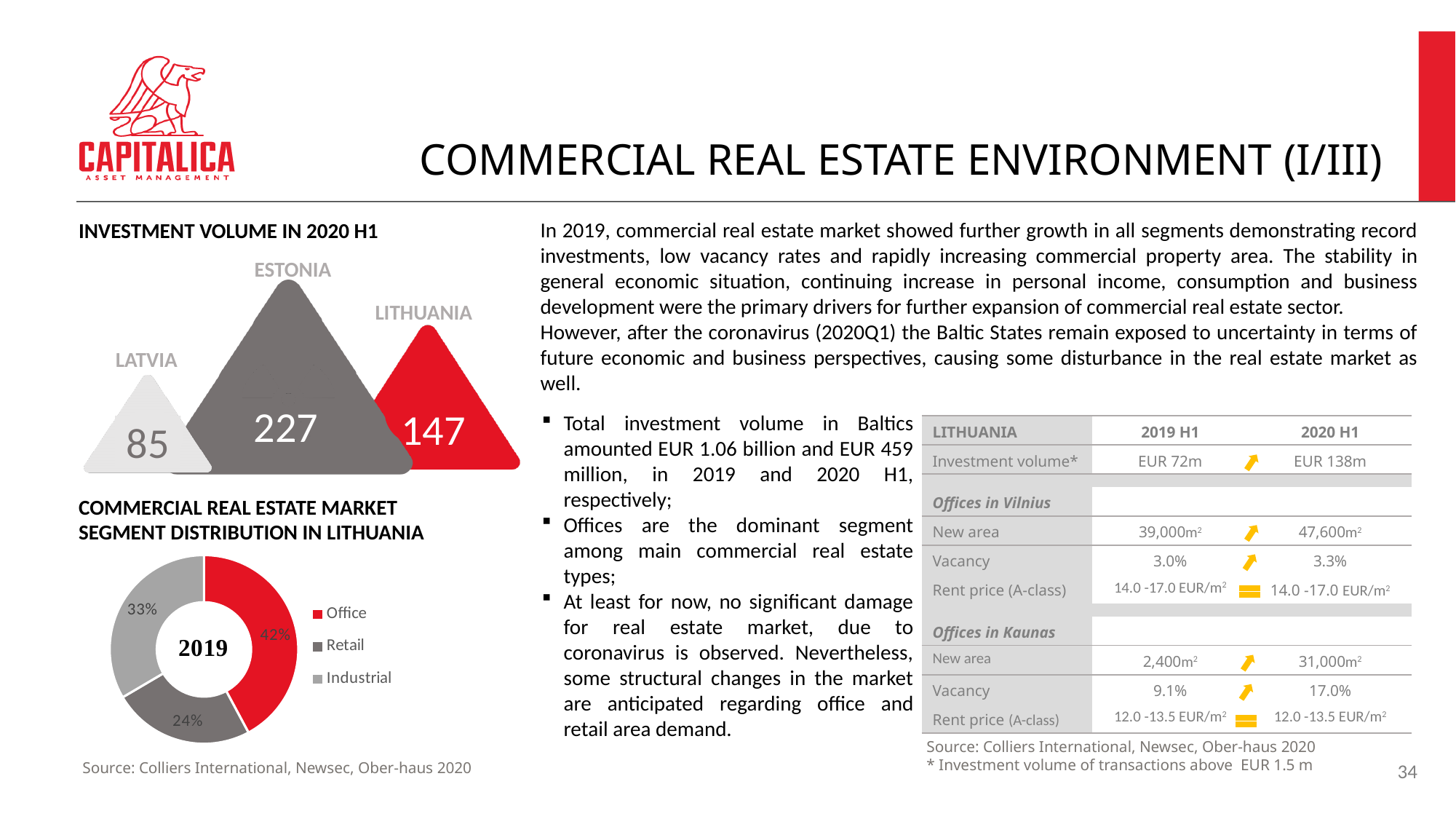
On the 'Investment Volume in 2020 H1' graphic, what is the value for Estonia? 227 On the 'Commercial Real Estate Market Segment Distribution in Lithuania' chart, which segment has the largest share? Office On the 'Commercial Real Estate Market Segment Distribution in Lithuania' chart, what share does Retail hold? 24% What type of chart is the 'Commercial Real Estate Market Segment Distribution in Lithuania' chart? Doughnut chart On the 'Commercial Real Estate Market Segment Distribution in Lithuania' chart, which segment has the smallest share? Retail On the 'Commercial Real Estate Market Segment Distribution in Lithuania' chart, how many segments are shown in the legend? 3 On the 'Commercial Real Estate Market Segment Distribution in Lithuania' chart, how many percentage points larger is Office than Retail? 18 On the 'Commercial Real Estate Market Segment Distribution in Lithuania' chart, what share does Office hold? 42% On the 'Commercial Real Estate Market Segment Distribution in Lithuania' chart, which is larger, Industrial or Retail? Industrial On the 'Investment Volume in 2020 H1' graphic, which country has the lowest value? Latvia What year is shown in the centre of the 'Commercial Real Estate Market Segment Distribution in Lithuania' chart? 2019 On the 'Commercial Real Estate Market Segment Distribution in Lithuania' chart, what share does Industrial hold? 33%